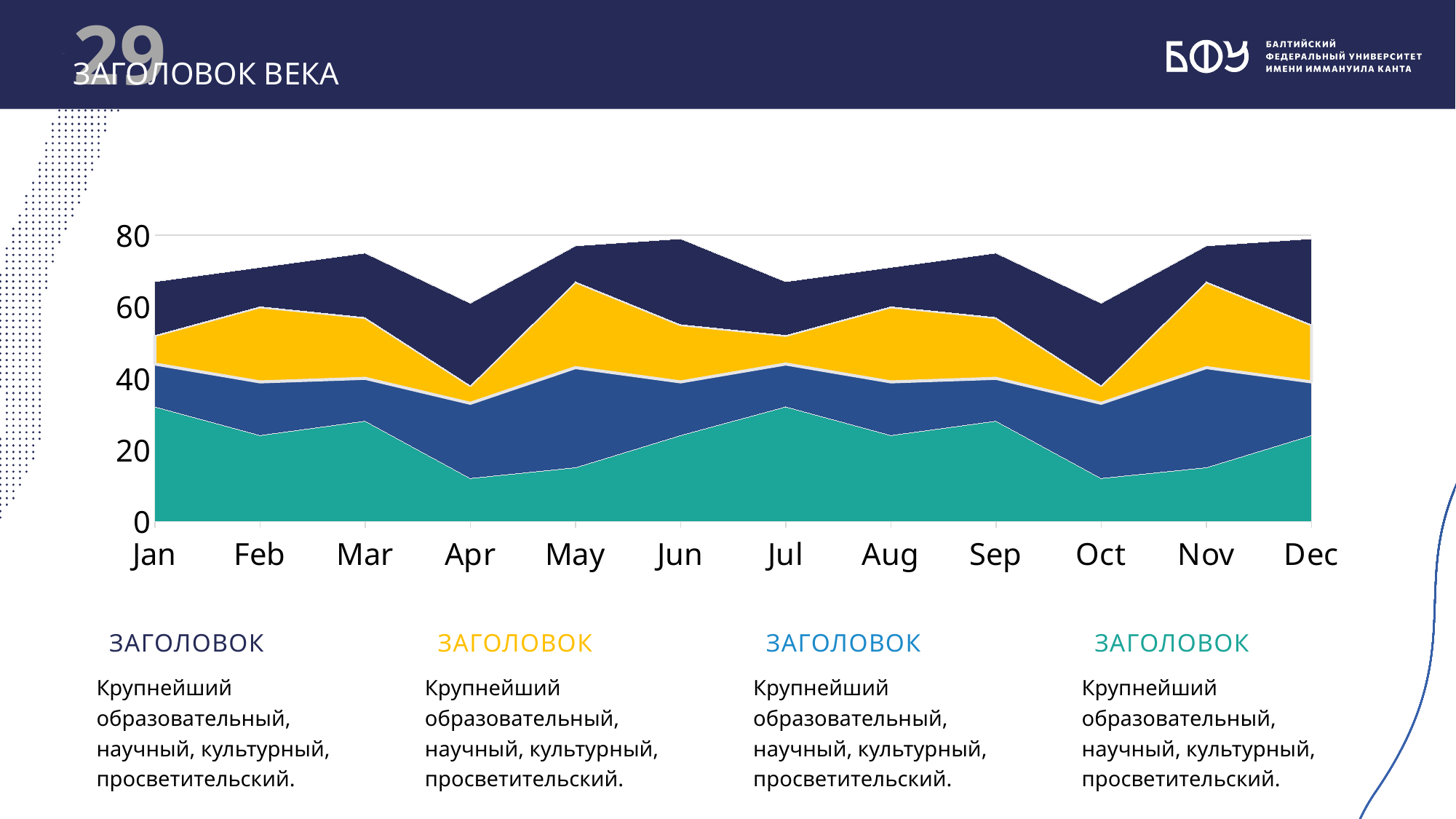
Does the bottom (teal) series rise or fall from Apr to Jul? rise Is the value of the bottom (teal) series for Jan greater or less than 20? greater How many coloured series are stacked in the chart? 4 Which month has the larger total stacked value, Jun or Oct? Jun Is the total stacked value for Jun greater or less than 60? greater How many categories are shown along the x axis of the chart? 12 Does the bottom (teal) series rise or fall from Jan to Apr? fall Which month has the larger value for the bottom (teal) series, Jan or Apr? Jan Is the total stacked value for Apr greater or less than 80? less What is the highest value labelled on the y axis of the chart? 80 What kind of chart is shown on the slide? Stacked area chart